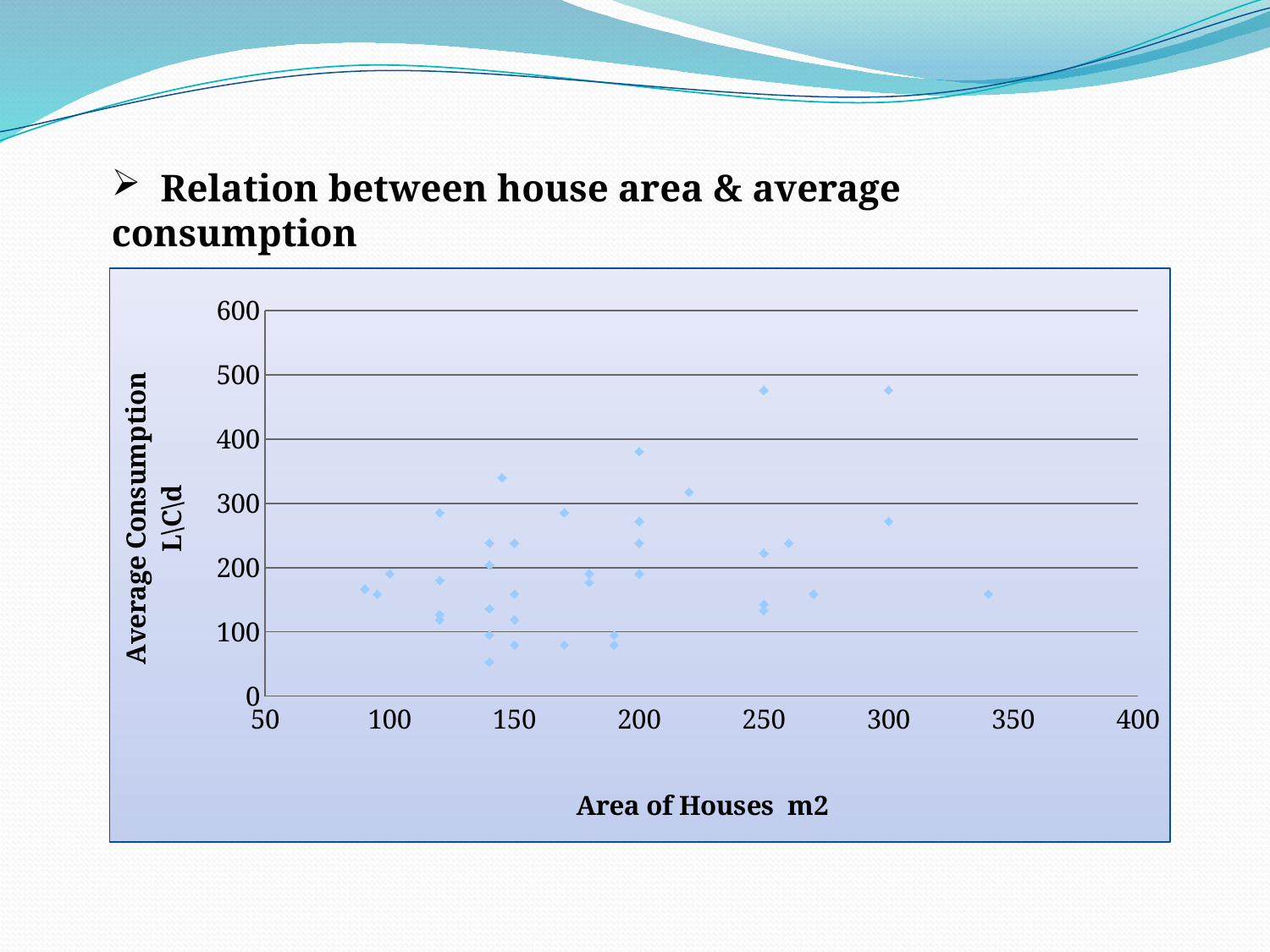
Is the highest average consumption plotted on the chart greater or less than 400? greater What kind of chart is shown on the slide? scatter chart Is the lowest average consumption plotted on the chart greater or less than 100? less Is the largest house area plotted on the chart greater or less than 300 m2? greater What is the label of the y axis of the chart? Average Consumption L\C\d What is the label of the x axis of the chart? Area of Houses m2 What is the maximum value shown on the y axis of the chart? 600